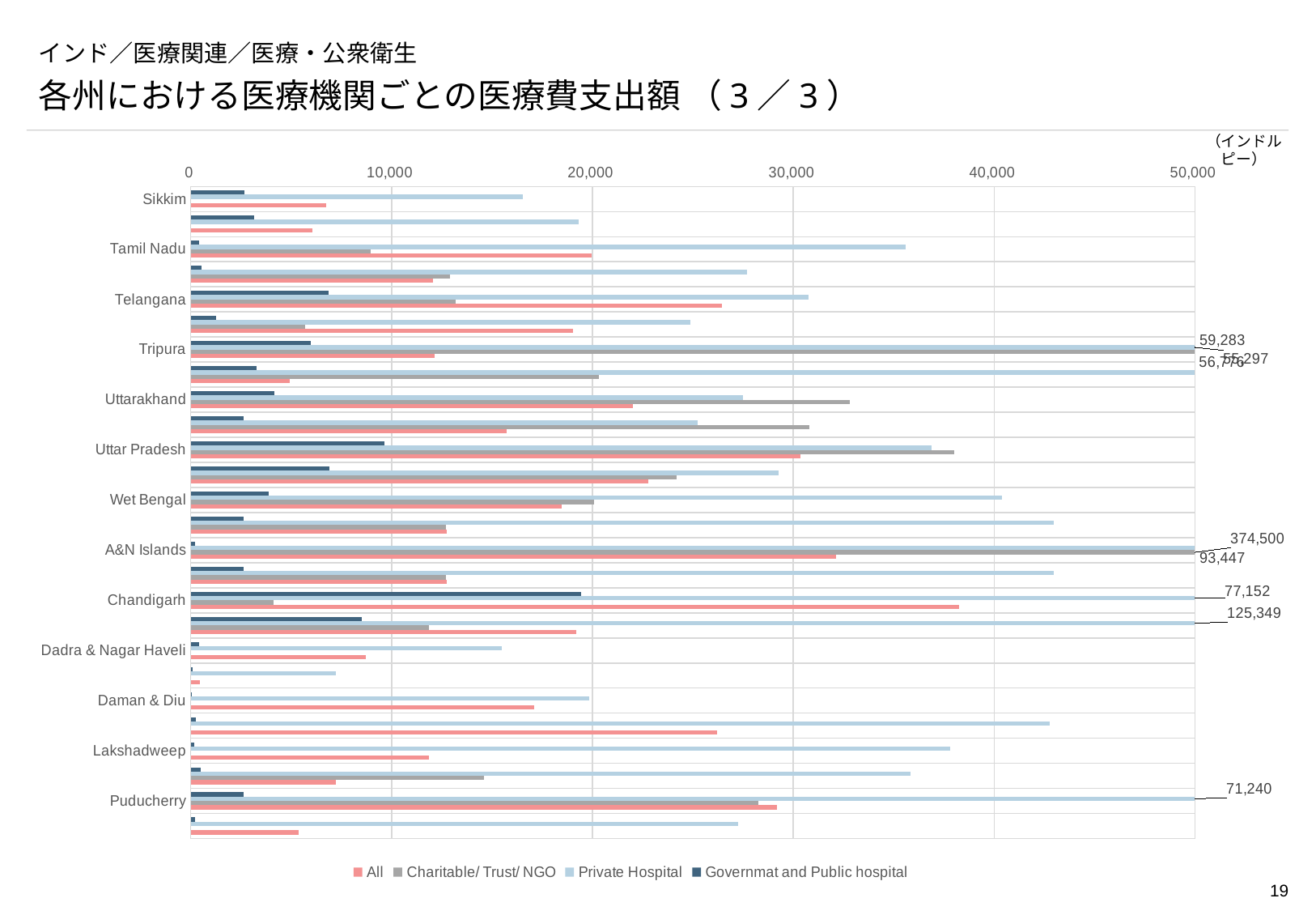
Is the value for Private Hospital in Dadra & Nagar Haveli greater or less than 20,000? less What type of chart is shown on the slide? bar chart What is the data label shown for the Charitable/ Trust/ NGO bar of Tripura that extends beyond the axis? 59,283 What is the difference between the two data labels printed for A&N Islands (374,500 and 93,447)? 281,053 For Sikkim, which is larger: the Private Hospital value or the Governmat and Public hospital value? Private Hospital Is the value for Private Hospital in Lakshadweep greater or less than 30,000? greater What unit is indicated at the top right of the chart? インドルピー How many series does the legend list? 4 What is the largest data label printed on the chart, and for which state? 374,500, A&N Islands What is the data label shown for the Private Hospital bar of Puducherry that extends beyond the axis? 71,240 Which series is shown in red in the legend? All What are the two data labels printed for Chandigarh? 77,152 and 125,349